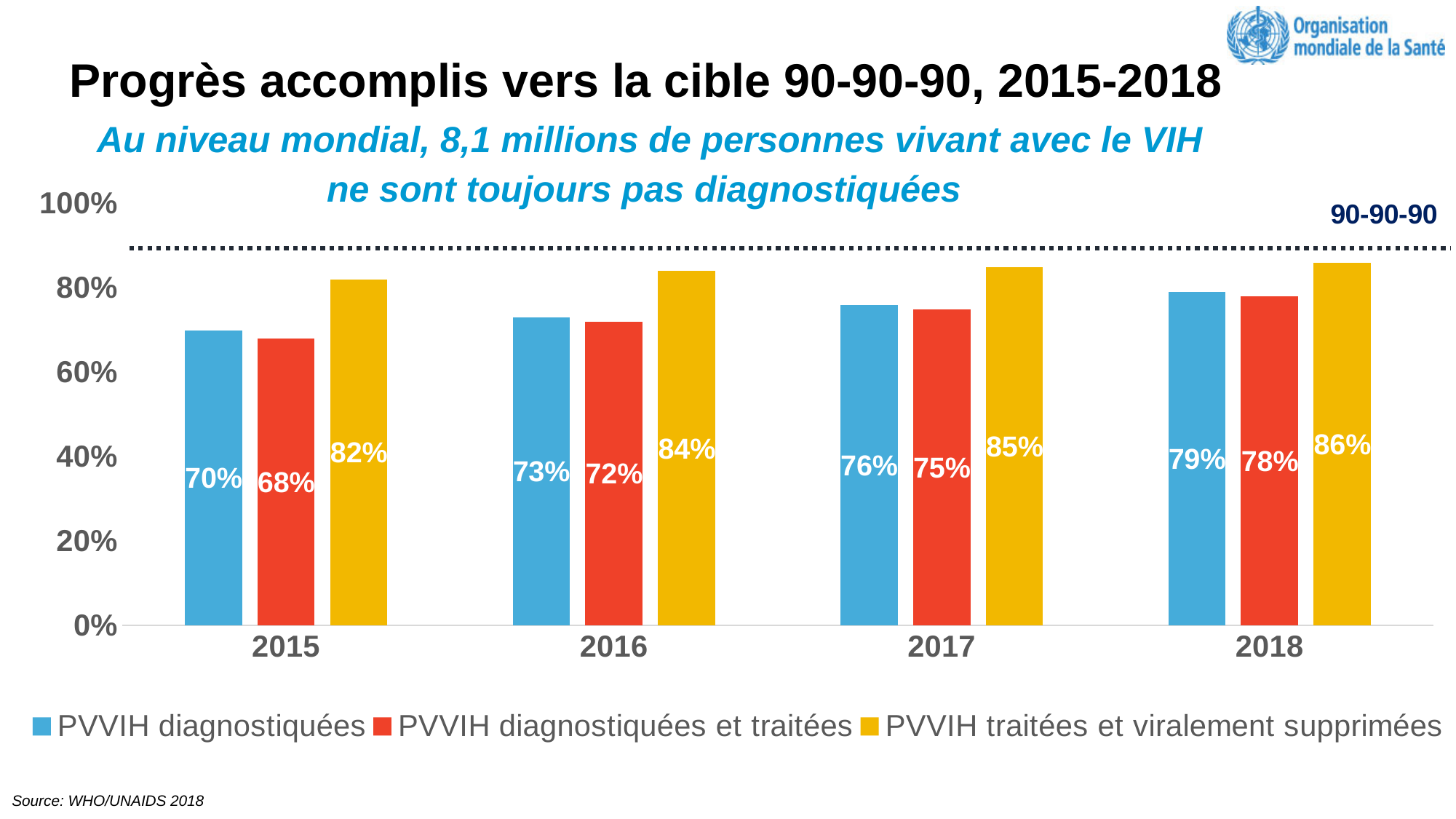
What is the value for PVVIH diagnostiquées in 2015? 70% How many years are shown on the x axis? 4 What is the value for PVVIH diagnostiquées et traitées in 2017? 75% What kind of chart is shown on the slide? Bar chart What is the value for PVVIH traitées et viralement supprimées in 2018? 86% What label is shown next to the dotted horizontal line on the chart? 90-90-90 What is the difference between PVVIH diagnostiquées in 2018 and in 2015? 9% Do the values for PVVIH traitées et viralement supprimées rise or fall from 2015 to 2018? Rise Which is larger in 2016: PVVIH diagnostiquées or PVVIH traitées et viralement supprimées? PVVIH traitées et viralement supprimées In which year is the value for PVVIH diagnostiquées highest? 2018 In which year is the value for PVVIH diagnostiquées et traitées lowest? 2015 How many series does the legend list? 3